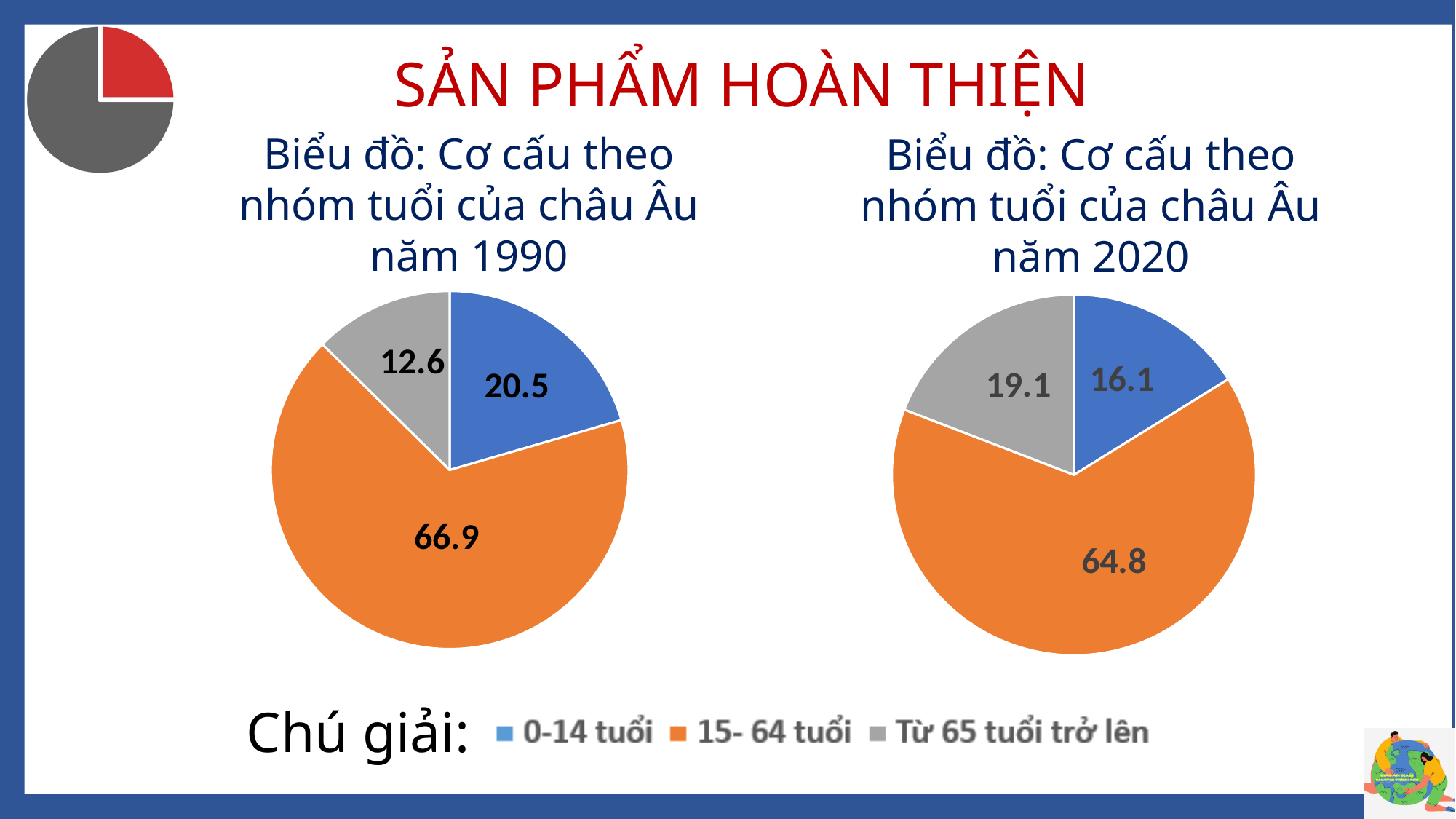
In the 2020 pie chart (right), which age group has the smallest slice? 0-14 tuổi Which colour represents the 15- 64 tuổi group in the legend? Orange In the 1990 pie chart (left), which age group has the smallest slice? Từ 65 tuổi trở lên Which is larger: the Từ 65 tuổi trở lên value in the 1990 chart or in the 2020 chart? 2020 What type of chart is used for the 1990 data on the left? Pie chart In the 2020 pie chart (right), which age group has the largest slice? 15- 64 tuổi In the 1990 pie chart (left), what is the value for the 15- 64 tuổi slice? 66.9 What is the difference between the 0-14 tuổi value in the 1990 chart and the 0-14 tuổi value in the 2020 chart? 4.4 How many slices does the 2020 pie chart (right) have? 3 In the 1990 pie chart (left), what is the difference between the 0-14 tuổi slice and the Từ 65 tuổi trở lên slice? 7.9 In the 1990 pie chart (left), what is the value for the 0-14 tuổi slice? 20.5 In the 2020 pie chart (right), what is the value for the Từ 65 tuổi trở lên slice? 19.1